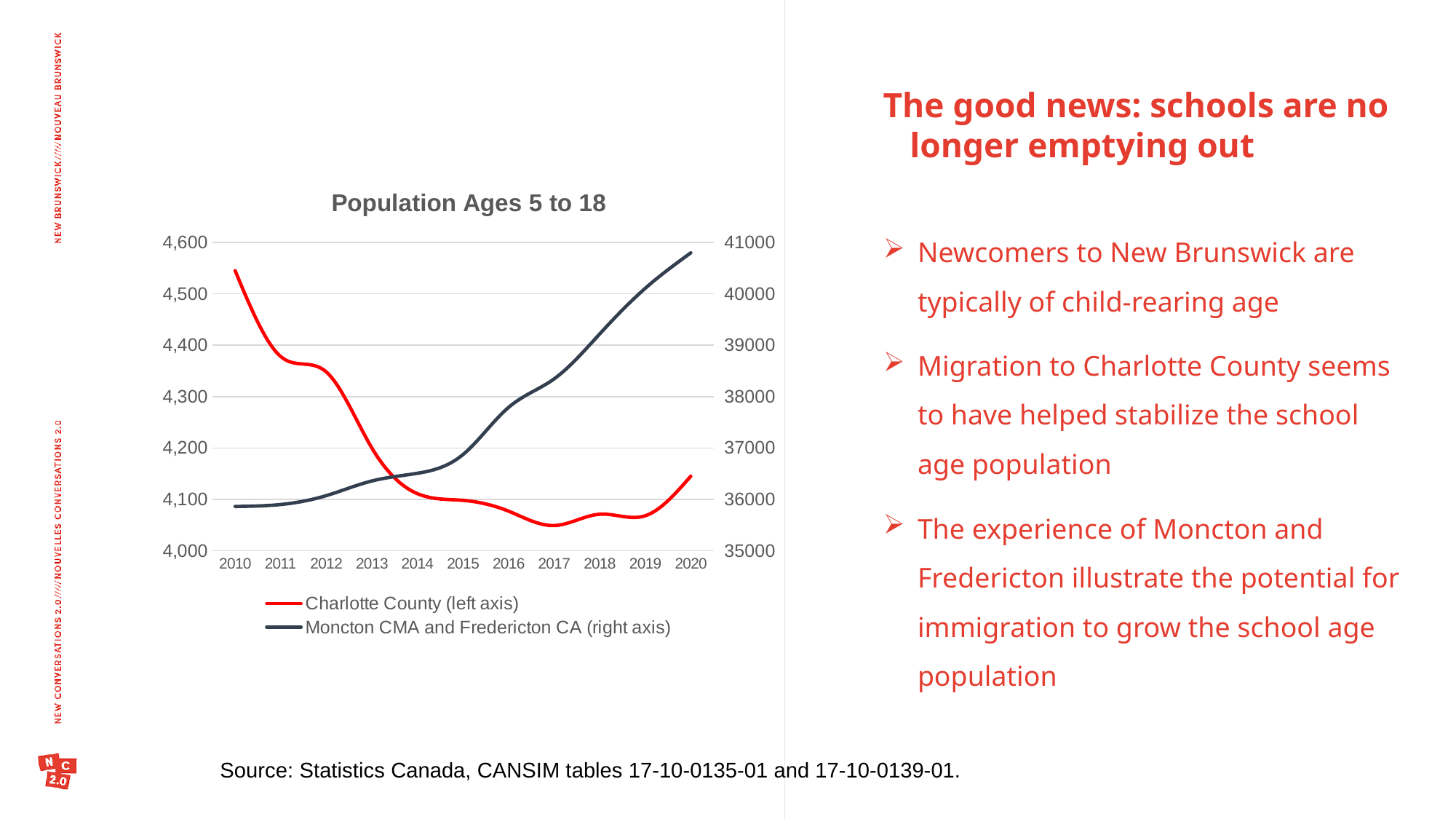
In which year is the Moncton CMA and Fredericton CA value lowest? 2010 How many years are shown along the x axis of the chart? 11 What is the title of the chart? Population Ages 5 to 18 Does the Charlotte County line rise or fall between 2010 and 2017? Fall Does the Moncton CMA and Fredericton CA line rise or fall from 2010 to 2020? Rise What kind of chart is shown on the slide? Line chart How many series does the chart's legend list? 2 Is the Moncton CMA and Fredericton CA value for 2020 greater or less than 40000? greater Is the Charlotte County value for 2017 greater or less than 4,100? less In which year is the Charlotte County value highest? 2010 Is the Charlotte County value for 2010 greater or less than 4,500? greater Which axis is the Charlotte County series plotted against? Left axis